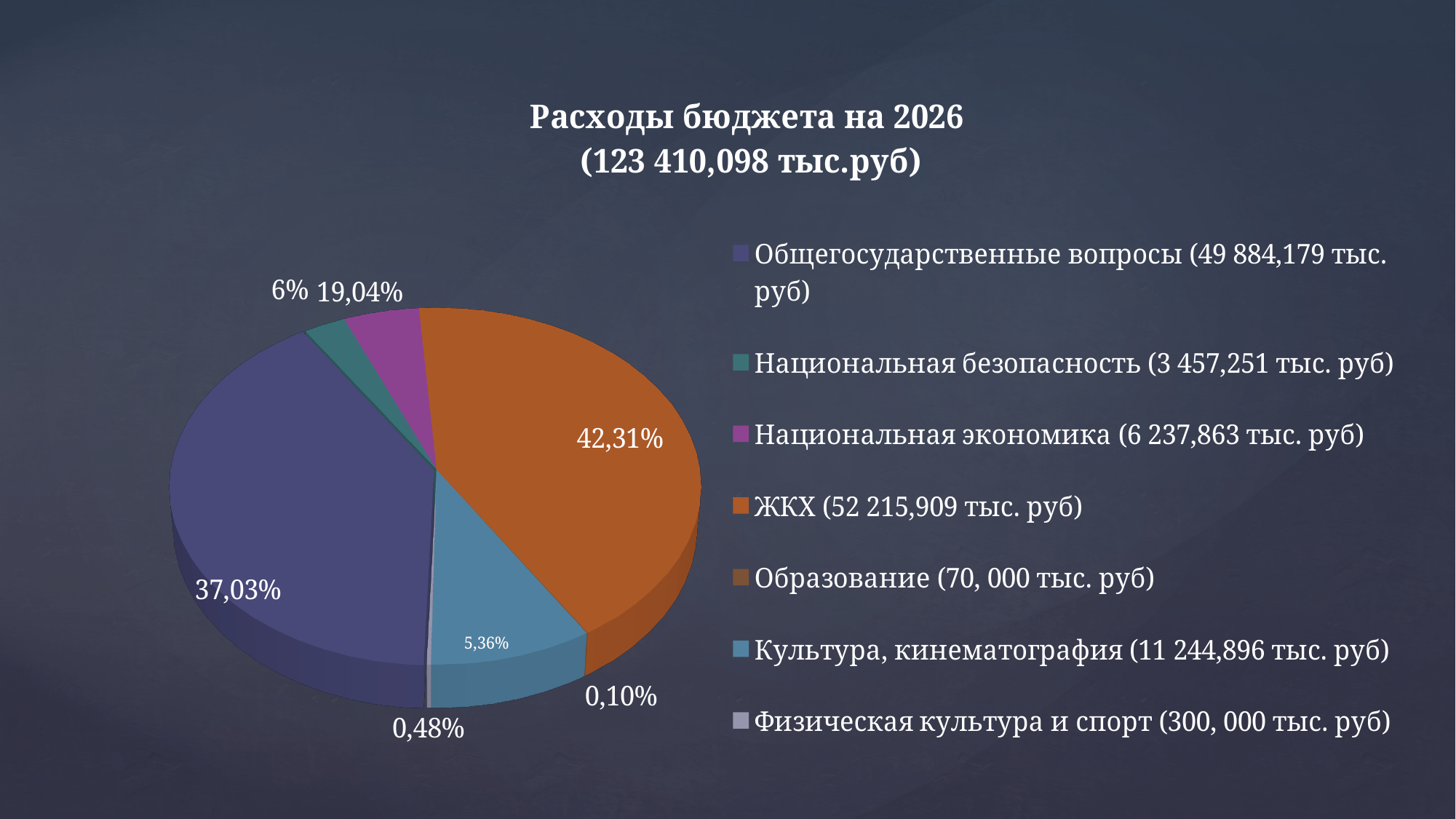
How many categories does the legend list? 7 What percentage share is labelled for Общегосударственные вопросы? 37,03% According to the legend, what amount is given for ЖКХ? 52 215,909 тыс. руб What kind of chart is shown on the slide? Pie chart What percentage share is labelled for ЖКХ? 42,31% What is the difference in percentage points between the ЖКХ share (42,31%) and the Общегосударственные вопросы share (37,03%)? 5,28% Which is larger: the share for ЖКХ or the share for Общегосударственные вопросы? ЖКХ Which category has the largest slice of the pie? ЖКХ What percentage share is labelled for Культура, кинематография? 5,36% What is the title of the chart? Расходы бюджета на 2026 (123 410,098 тыс.руб) Which category has the smallest labelled share? Образование According to the legend, what amount is given for Физическая культура и спорт? 300, 000 тыс. руб